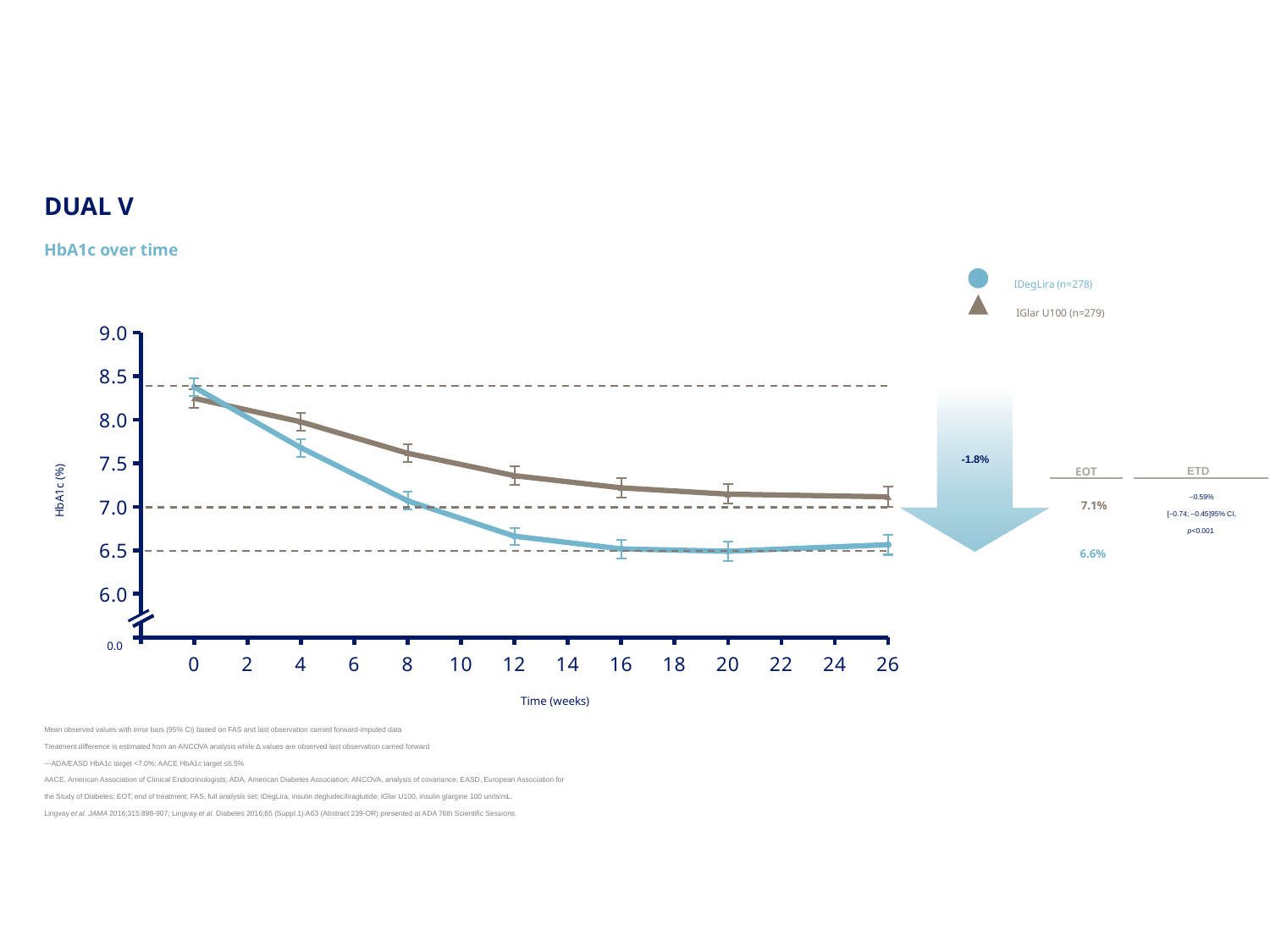
How many series does the legend list? 2 What is the label of the x axis? Time (weeks) What is the difference between the EOT HbA1c values for IGlar U100 and IDegLira? 0.5% What kind of chart is shown on the slide? line chart What is the estimated treatment difference (ETD) shown on the slide? −0.59% Which series has the lower HbA1c at week 26, IDegLira or IGlar U100? IDegLira Do the HbA1c values for IDegLira rise or fall from week 0 to week 26? fall What is the end-of-treatment (EOT) HbA1c value shown for IDegLira? 6.6% Is the HbA1c value for IGlar U100 at week 12 greater or less than 7.0? greater What is the end-of-treatment (EOT) HbA1c value shown for IGlar U100? 7.1% How many data points are plotted for each series? 7 Is the HbA1c value for IDegLira at week 16 greater or less than 7.0? less